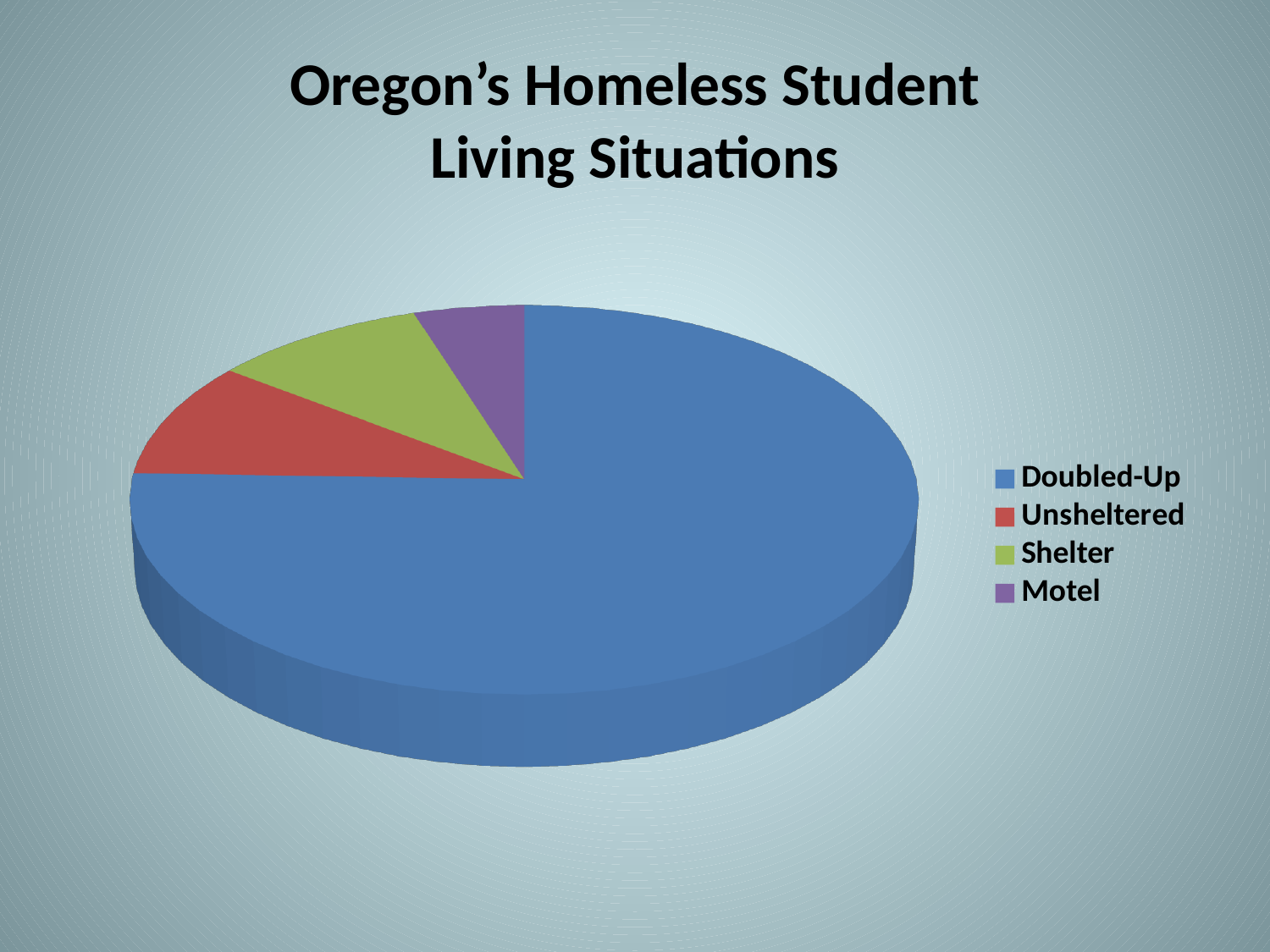
Which living situation has the largest slice of the pie? Doubled-Up Does Doubled-Up account for more or less than half of the pie? More How many categories does the pie chart show? 4 Which slice is larger, Doubled-Up or Shelter? Doubled-Up What kind of chart is shown on the slide? Pie chart Which colour represents Shelter in the legend? Green Which slice is larger, Motel or Doubled-Up? Doubled-Up Which living situation has the smallest slice of the pie? Motel What is the title of the chart? Oregon's Homeless Student Living Situations